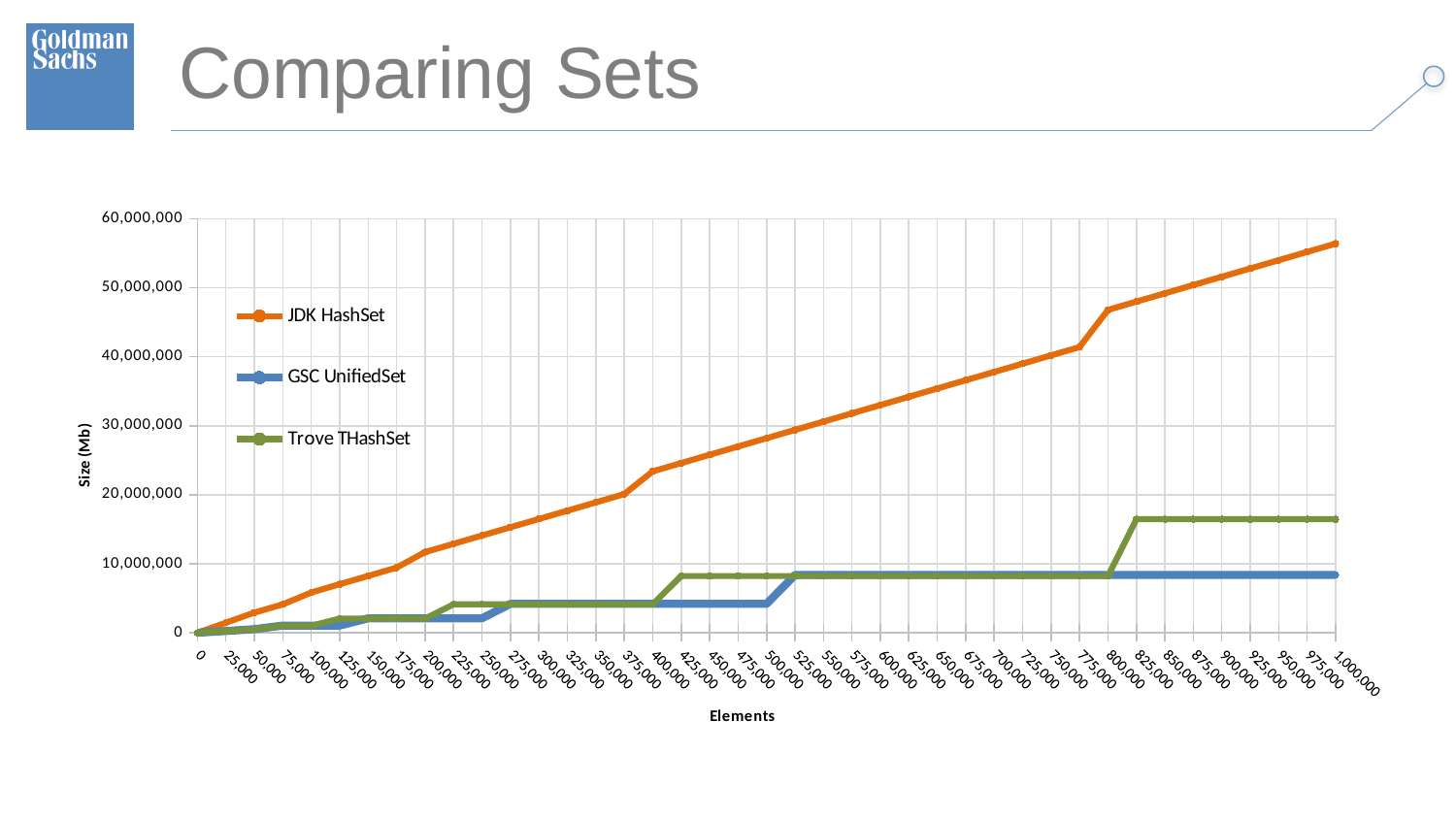
Which series has the highest value at 1,000,000 elements? JDK HashSet At 1,000,000 elements, which is larger: Trove THashSet or GSC UnifiedSet? Trove THashSet Is the value for Trove THashSet at 1,000,000 elements greater or less than 20,000,000? less Is the value for GSC UnifiedSet at 1,000,000 elements greater or less than 10,000,000? less Which series are listed in the legend? JDK HashSet, GSC UnifiedSet, Trove THashSet How many series does the legend list? 3 Which series has the lowest value at 1,000,000 elements? GSC UnifiedSet Is the value for JDK HashSet at 1,000,000 elements greater or less than 50,000,000? greater What are the titles of the x axis and the y axis? Elements; Size (Mb) Does the JDK HashSet series rise or fall as the number of elements increases? rise What kind of chart is shown on the slide? line chart